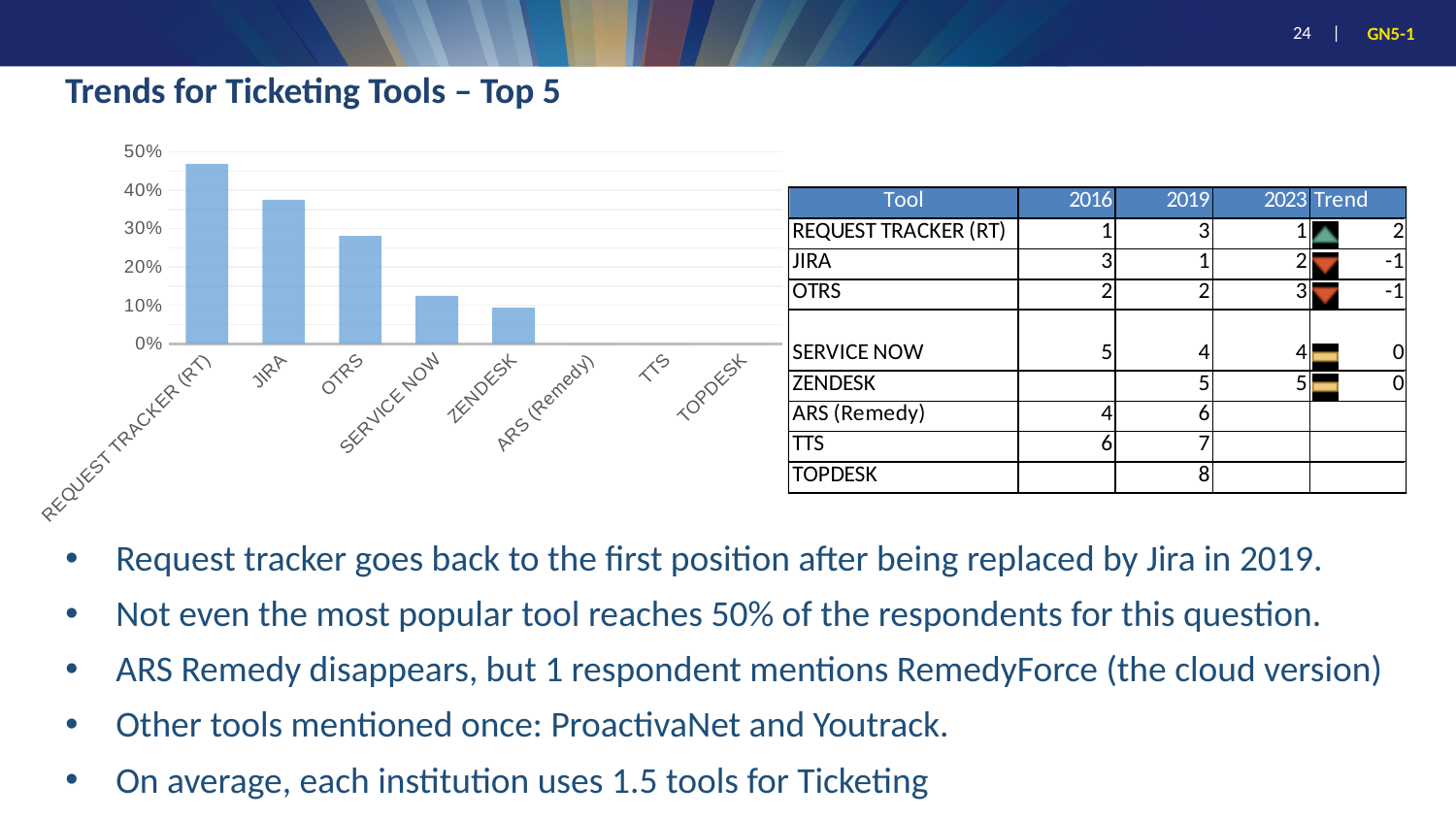
What is the title of the slide containing the chart? Trends for Ticketing Tools – Top 5 Is the value for REQUEST TRACKER (RT) greater or less than 40%? greater How many categories are shown on the x axis of the bar chart? 8 Do the bar values rise or fall from left to right along the x axis? Fall Which tool has the highest bar in the chart? REQUEST TRACKER (RT) Is the value for OTRS greater or less than 20%? greater Which has a larger value, JIRA or OTRS? JIRA Which has a larger value, SERVICE NOW or ZENDESK? SERVICE NOW Is the value for JIRA greater or less than 30%? greater What kind of chart is shown on the slide? Bar chart